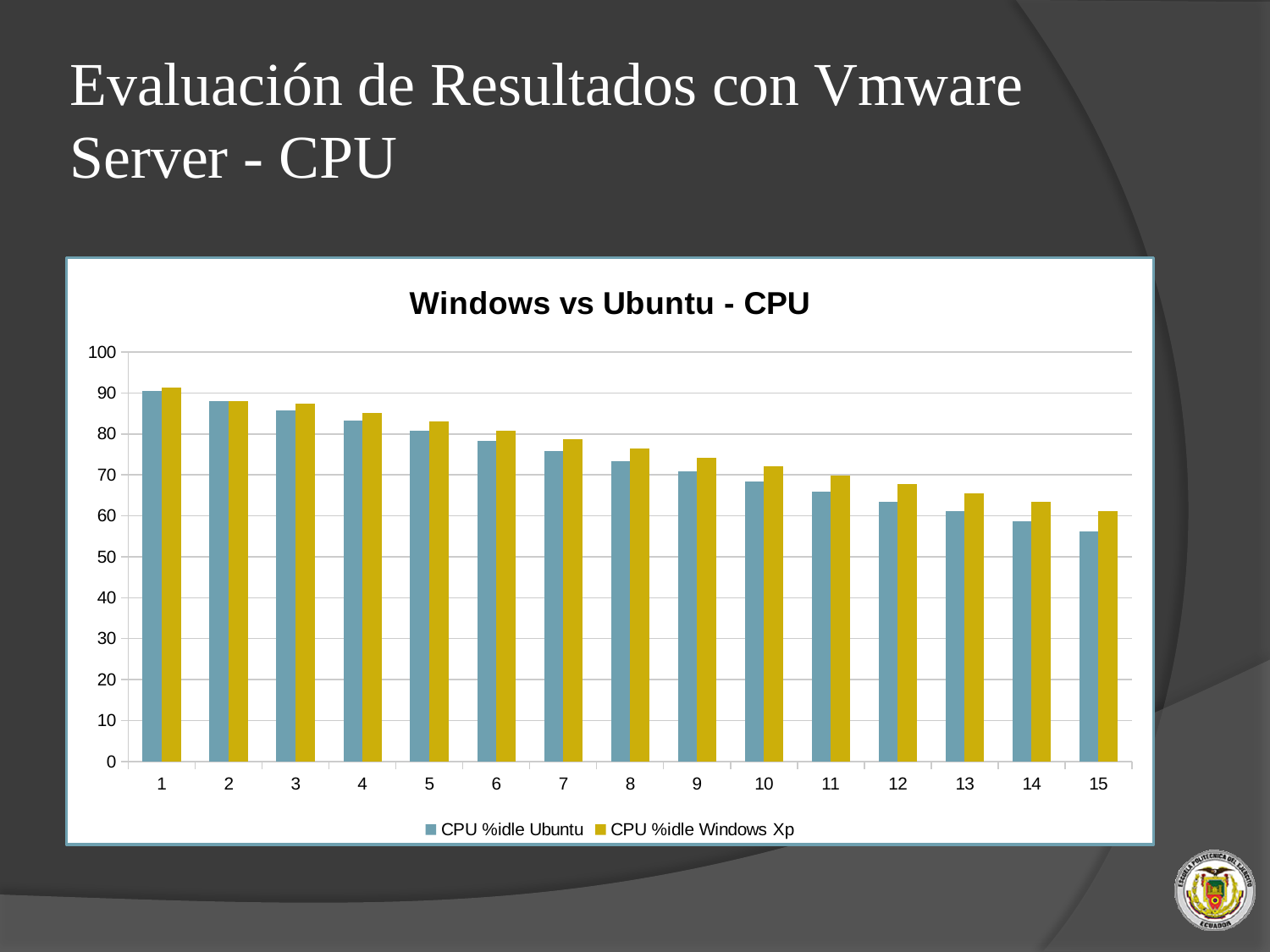
Do the values for CPU %idle Ubuntu rise or fall from category 1 to category 15? fall Which series is shown in yellow in the legend? CPU %idle Windows Xp How many categories are shown on the x axis? 15 Which category has the lowest value for CPU %idle Windows Xp? 15 Is the value for CPU %idle Ubuntu at category 8 greater or less than 70? greater Is the value for CPU %idle Windows Xp at category 1 greater or less than 90? greater What type of chart is shown on the slide? bar chart How many series does the legend list? 2 What is the title of the chart? Windows vs Ubuntu - CPU Which category has the highest value for CPU %idle Ubuntu? 1 At category 15, which series has the larger value, CPU %idle Ubuntu or CPU %idle Windows Xp? CPU %idle Windows Xp Is the value for CPU %idle Ubuntu at category 15 greater or less than 60? less